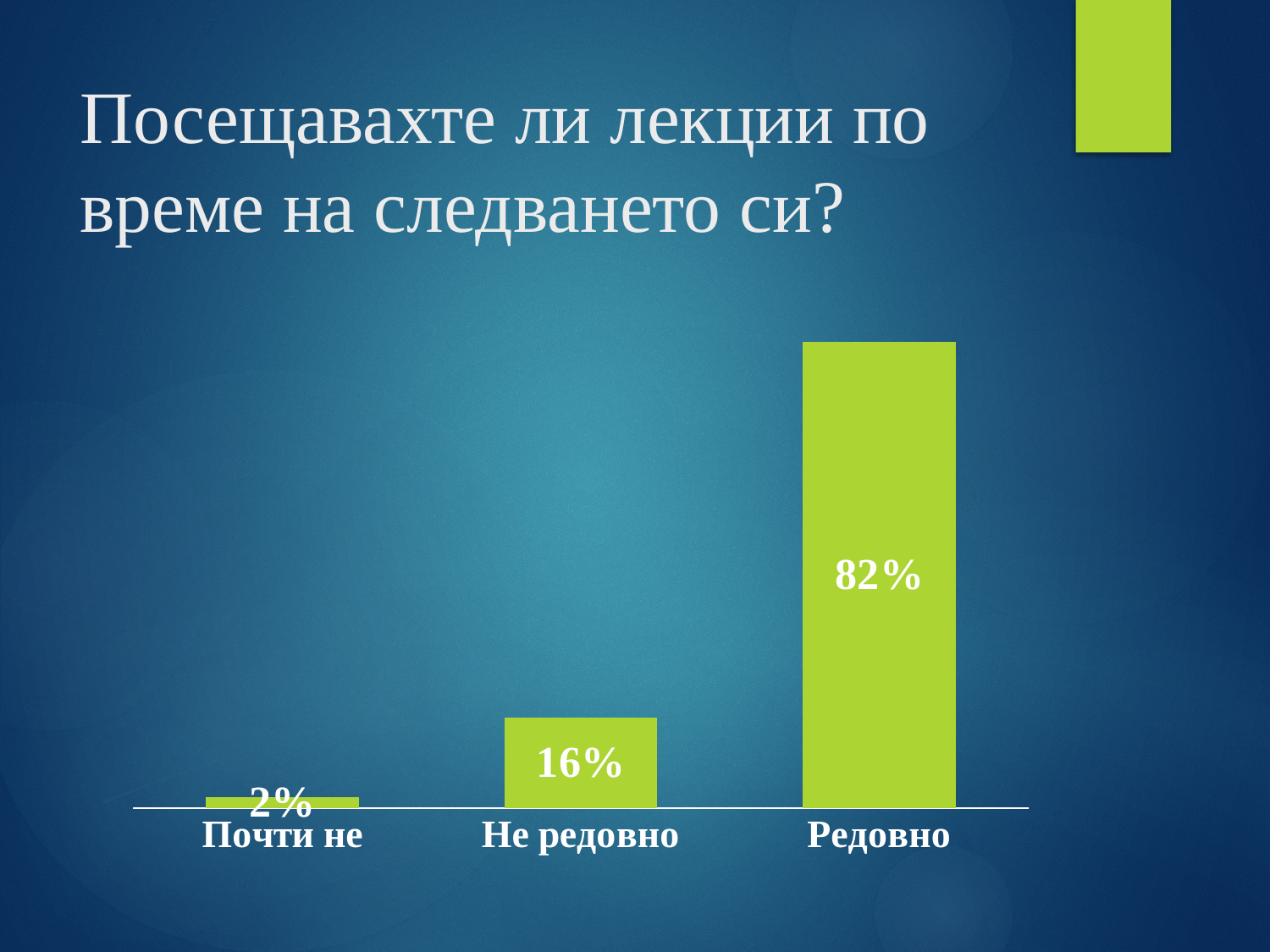
Which category has the highest value? Редовно What is the value for Почти не? 2% What is the title of the slide containing the chart? Посещавахте ли лекции по време на следването си? Do the values rise or fall from left to right along the x axis? rise Which is larger, the value for Не редовно or the value for Почти не? Не редовно What is the difference between the values for Редовно and Не редовно? 66% What is the difference between the values for Не редовно and Почти не? 14% What is the value for Редовно? 82% What kind of chart is shown on the slide? bar chart What is the value for Не редовно? 16% Which category has the lowest value? Почти не How many categories are shown in the chart? 3